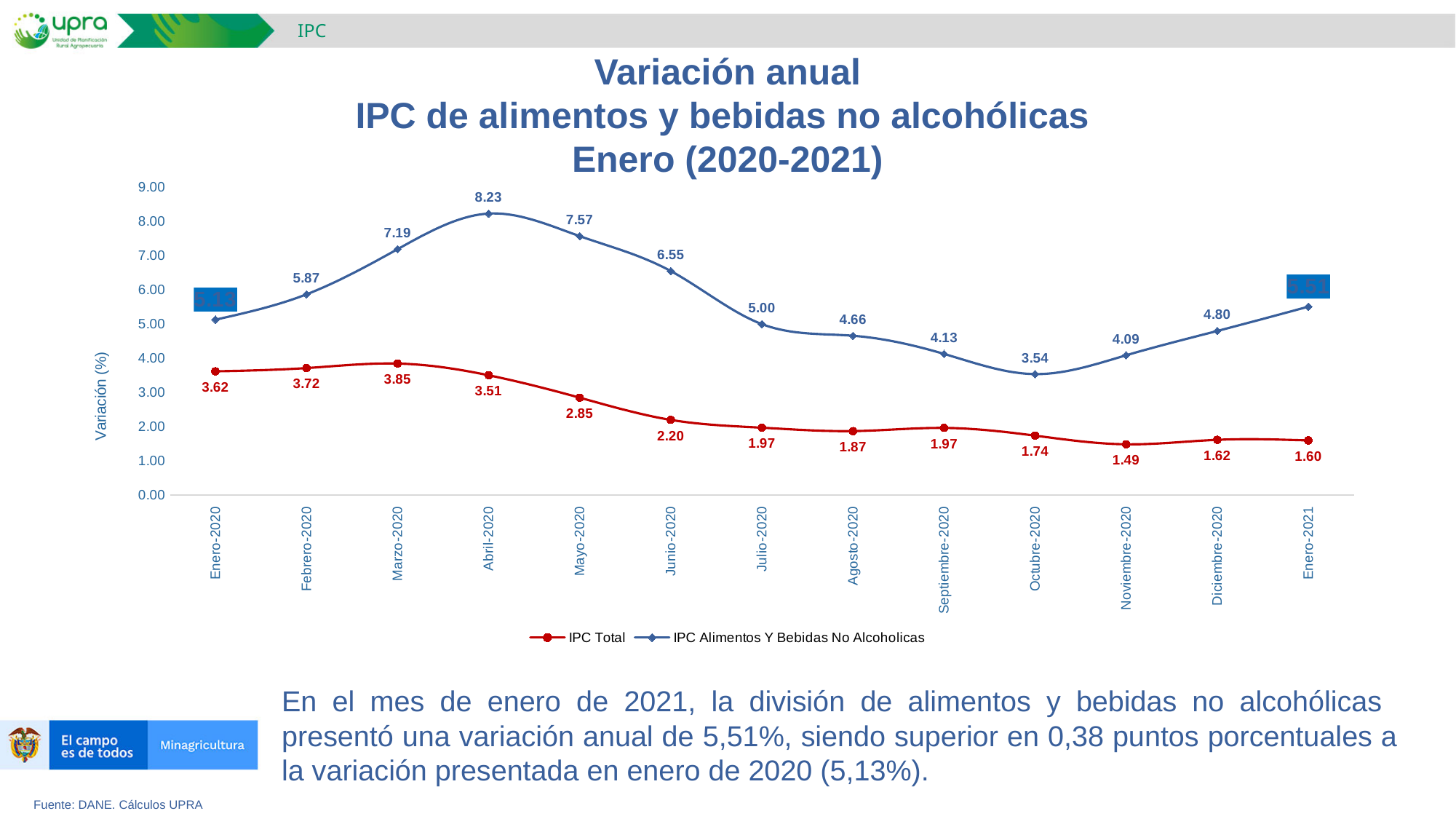
What is the value of IPC Alimentos Y Bebidas No Alcoholicas for Octubre-2020? 3.54 In which month does IPC Alimentos Y Bebidas No Alcoholicas reach its highest value? Abril-2020 What colour is the IPC Total line? red What is the value of IPC Alimentos Y Bebidas No Alcoholicas for Abril-2020? 8.23 How many series does the legend list? 2 Which is larger in Mayo-2020: IPC Total or IPC Alimentos Y Bebidas No Alcoholicas? IPC Alimentos Y Bebidas No Alcoholicas How many months are plotted along the x axis? 13 What type of chart is shown on the slide? line chart What is the difference between IPC Alimentos Y Bebidas No Alcoholicas and IPC Total in Abril-2020? 4.72 In which month does IPC Total reach its lowest value? Noviembre-2020 What is the value of IPC Total for Noviembre-2020? 1.49 Does IPC Total rise or fall from Marzo-2020 to Noviembre-2020? fall